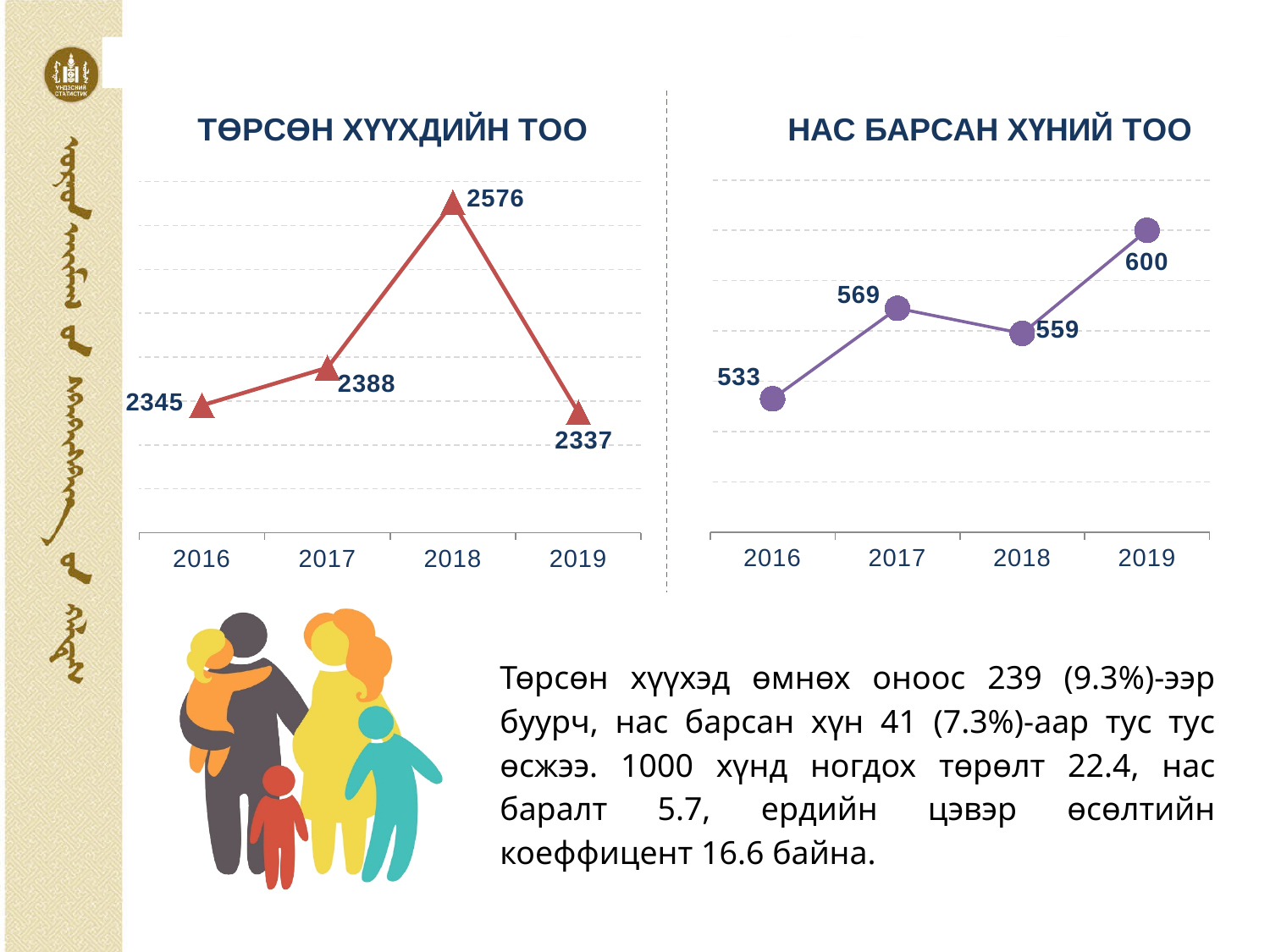
In the 'НАС БАРСАН ХҮНИЙ ТОО' chart, what colour is the line? Purple In the 'НАС БАРСАН ХҮНИЙ ТОО' chart, what is the value for 2019? 600 In the 'НАС БАРСАН ХҮНИЙ ТОО' chart, which is larger, the value for 2017 or 2018? 2017 In the 'ТӨРСӨН ХҮҮХДИЙН ТОО' chart, what is the value for 2018? 2576 In the 'НАС БАРСАН ХҮНИЙ ТОО' chart, what is the difference between the 2019 and 2018 values? 41 What type of chart is the 'НАС БАРСАН ХҮНИЙ ТОО' chart? Line chart In the 'НАС БАРСАН ХҮНИЙ ТОО' chart, what is the value for 2017? 569 In the 'ТӨРСӨН ХҮҮХДИЙН ТОО' chart, what is the difference between the 2018 and 2019 values? 239 In the 'НАС БАРСАН ХҮНИЙ ТОО' chart, which year has the lowest value? 2016 In the 'ТӨРСӨН ХҮҮХДИЙН ТОО' chart, which year has the lowest value? 2019 In the 'ТӨРСӨН ХҮҮХДИЙН ТОО' chart, what is the value for 2016? 2345 In the 'ТӨРСӨН ХҮҮХДИЙН ТОО' chart, how many data points are plotted? 4